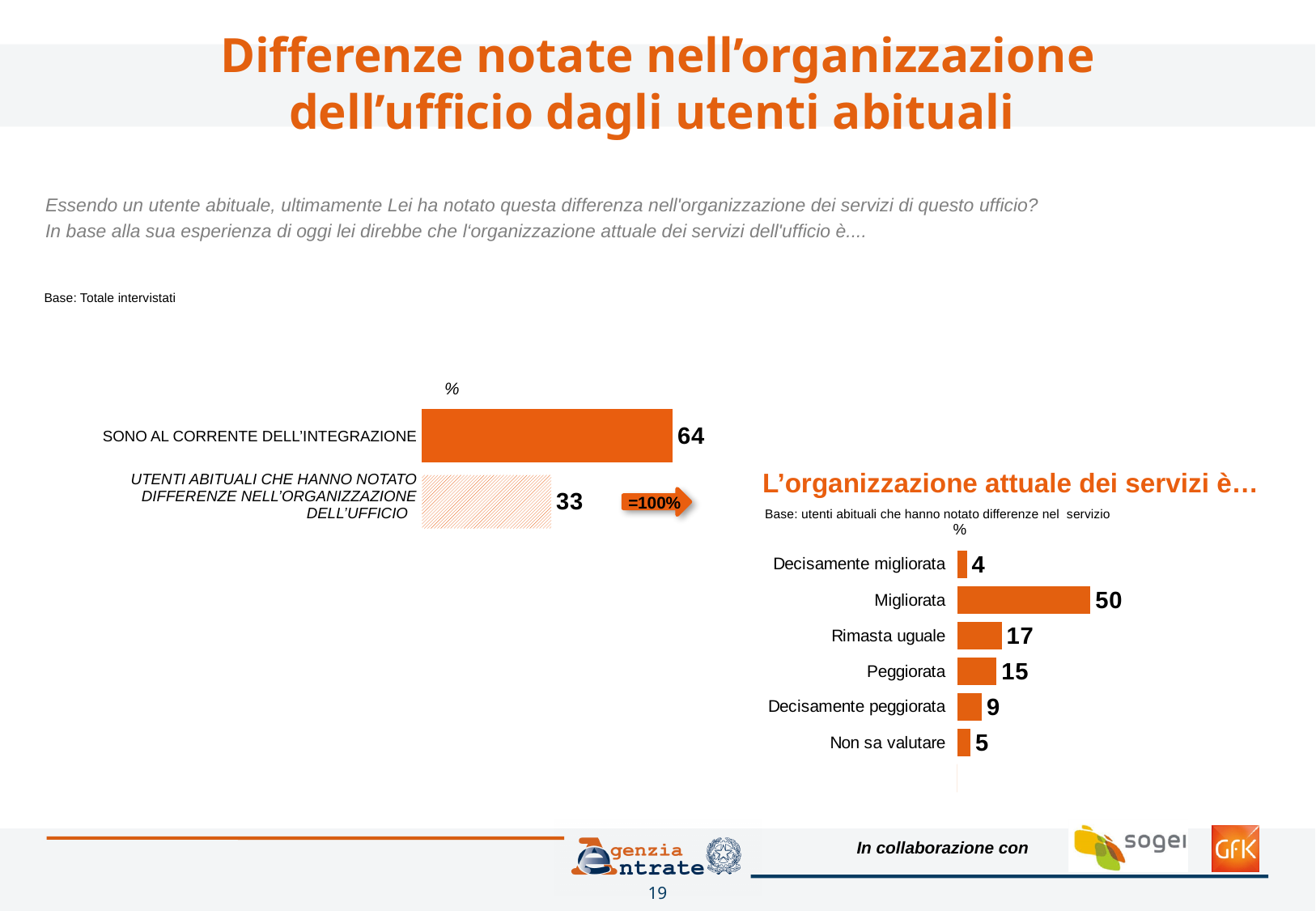
In the left chart, what is the difference between the value for "SONO AL CORRENTE DELL'INTEGRAZIONE" and the value for "UTENTI ABITUALI CHE HANNO NOTATO DIFFERENZE NELL'ORGANIZZAZIONE DELL'UFFICIO"? 31 In the left chart, what is the value for "SONO AL CORRENTE DELL'INTEGRAZIONE"? 64 In the chart "L'organizzazione attuale dei servizi è…", what is the value for "Migliorata"? 50 In the chart "L'organizzazione attuale dei servizi è…", which category has the lowest value? Decisamente migliorata In the chart "L'organizzazione attuale dei servizi è…", what is the value for "Peggiorata"? 15 In the chart "L'organizzazione attuale dei servizi è…", what is the value for "Non sa valutare"? 5 In the chart "L'organizzazione attuale dei servizi è…", what is the difference between the value for "Migliorata" and the value for "Rimasta uguale"? 33 In the left chart, what is the value for "UTENTI ABITUALI CHE HANNO NOTATO DIFFERENZE NELL'ORGANIZZAZIONE DELL'UFFICIO"? 33 How many categories are shown in the chart "L'organizzazione attuale dei servizi è…"? 6 In the chart "L'organizzazione attuale dei servizi è…", which is larger: the value for "Rimasta uguale" or the value for "Decisamente peggiorata"? Rimasta uguale In the chart "L'organizzazione attuale dei servizi è…", which category has the highest value? Migliorata What kind of chart is "L'organizzazione attuale dei servizi è…"? Bar chart